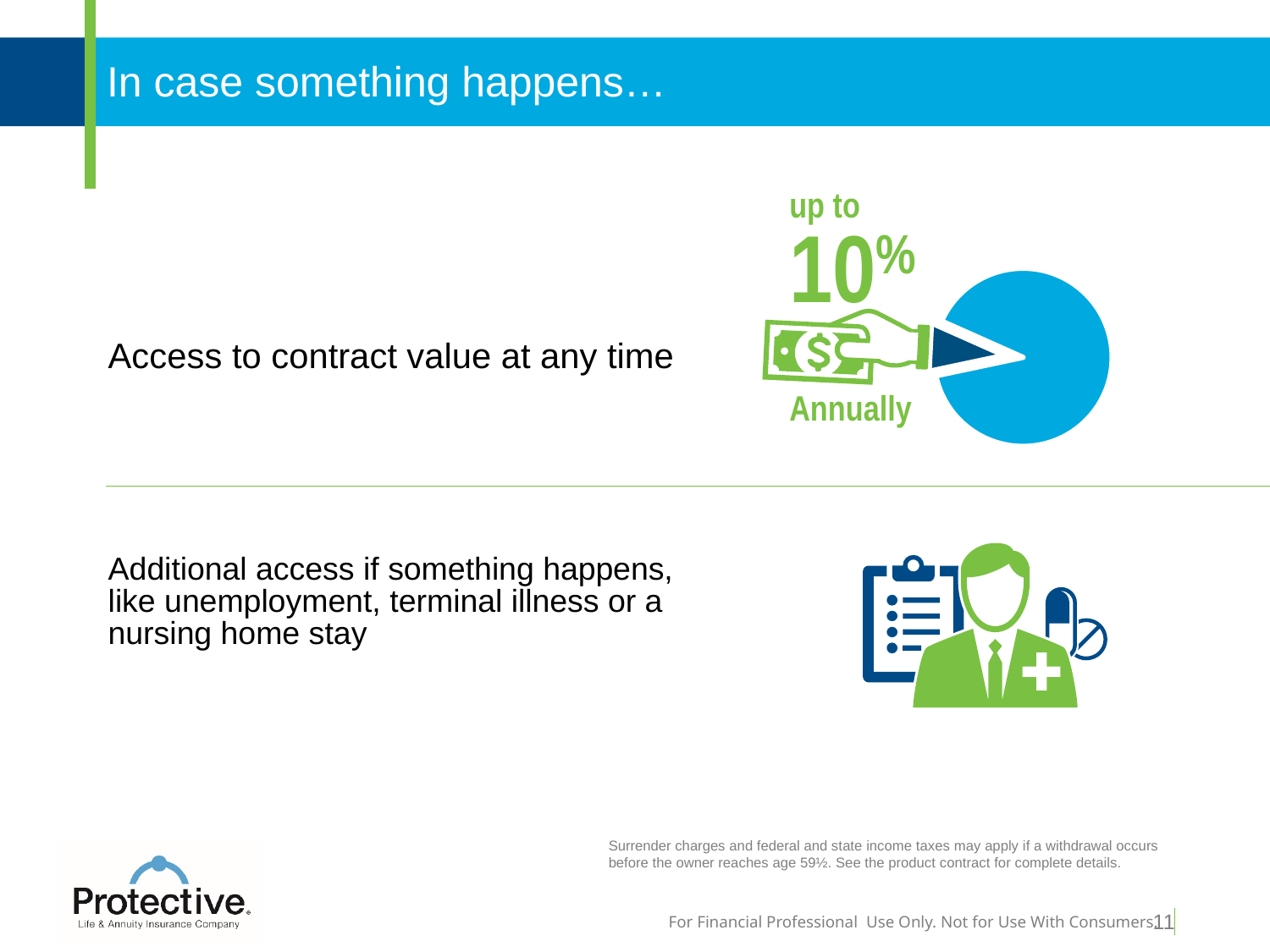
What kind of chart shape is used in the graphic next to 'Access to contract value at any time'? pie chart What word is printed below the pie graphic, indicating how often the 10% access applies? Annually What percentage is printed above the pie graphic on the slide? 10% What two words appear directly above the '10%' figure on the slide? up to